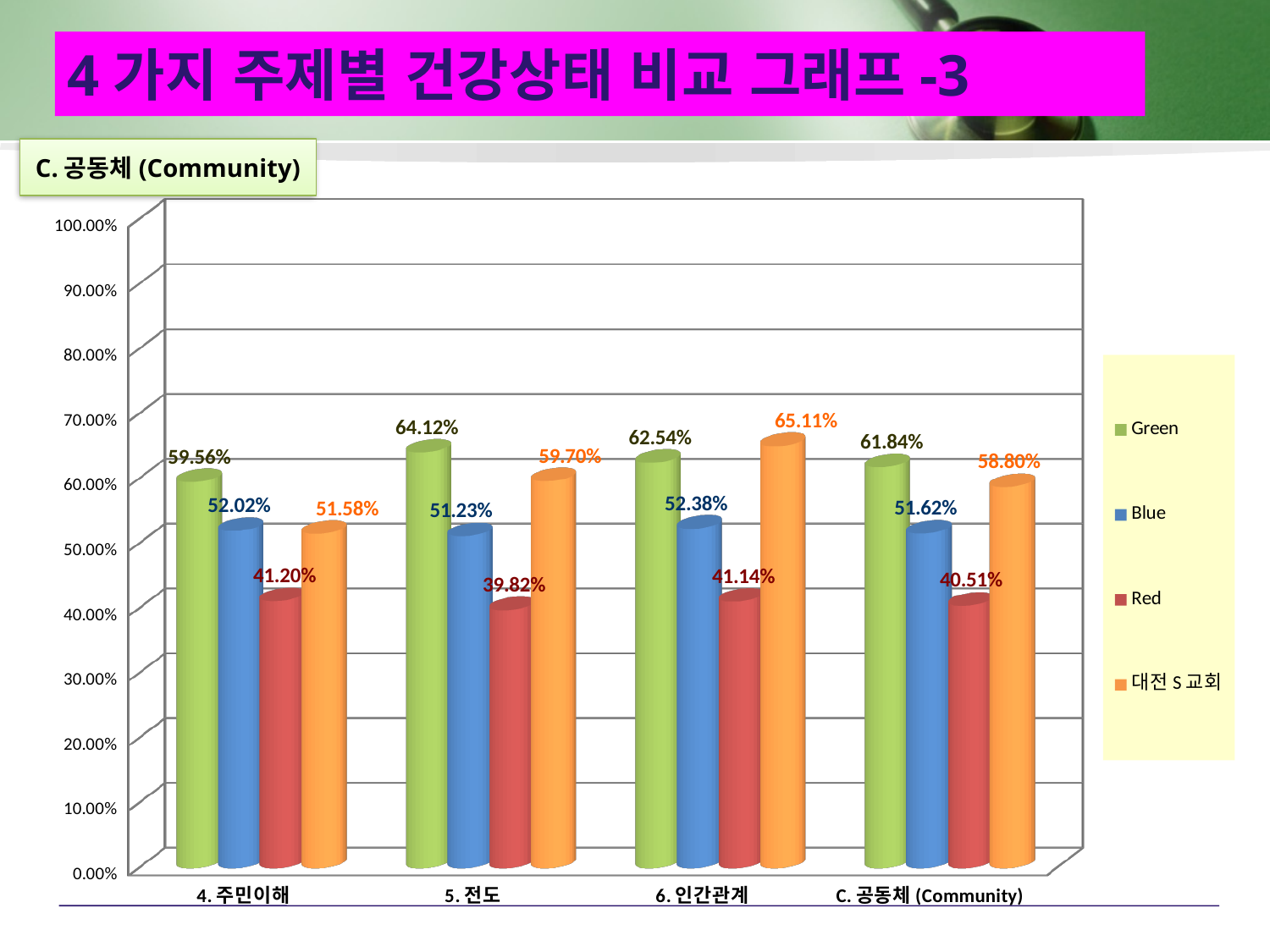
Which category has the lowest Red value? 5. 전도 How many categories are shown on the x axis? 4 What is the difference between the Green and Red values for 4. 주민이해? 18.36% Which category has the highest Green value? 5. 전도 What kind of chart is shown on the slide? Bar chart For 6. 인간관계, which is larger: the Green value or the 대전 S 교회 value? 대전 S 교회 How many series does the legend list? 4 What is the value of the 대전 S 교회 series for 6. 인간관계? 65.11% What is the value of the Green series for 5. 전도? 64.12% What is the last entry in the chart legend? 대전 S 교회 What is the value of the Blue series for 4. 주민이해? 52.02% What is the value of the Red series for C. 공동체 (Community)? 40.51%